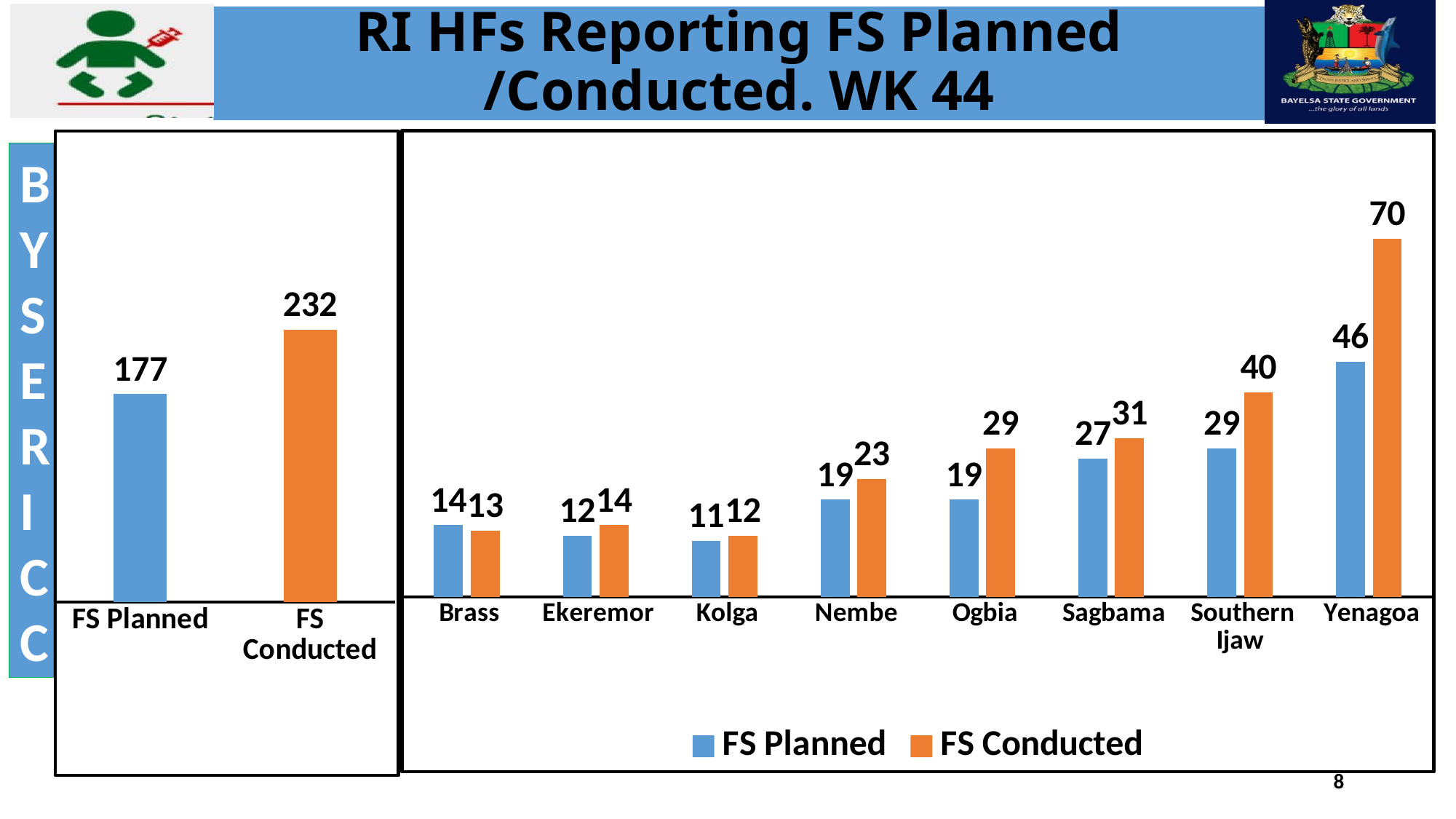
What type of chart is the right chart? Bar chart In the right chart, what is the FS Conducted value for Yenagoa? 70 In the left chart, what is the value for FS Planned? 177 How many LGAs are shown on the x axis of the right chart? 8 In the right chart, what is the FS Planned value for Sagbama? 27 In the right chart, which is larger for Brass: FS Planned or FS Conducted? FS Planned In the right chart, which LGA has the highest FS Conducted value? Yenagoa In the left chart, what is the value for FS Conducted? 232 In the right chart, what is the difference between FS Conducted and FS Planned for Yenagoa? 24 How many series does the legend of the right chart list? 2 In the right chart, which LGA has the lowest FS Planned value? Kolga In the left chart, what is the difference between FS Conducted and FS Planned? 55